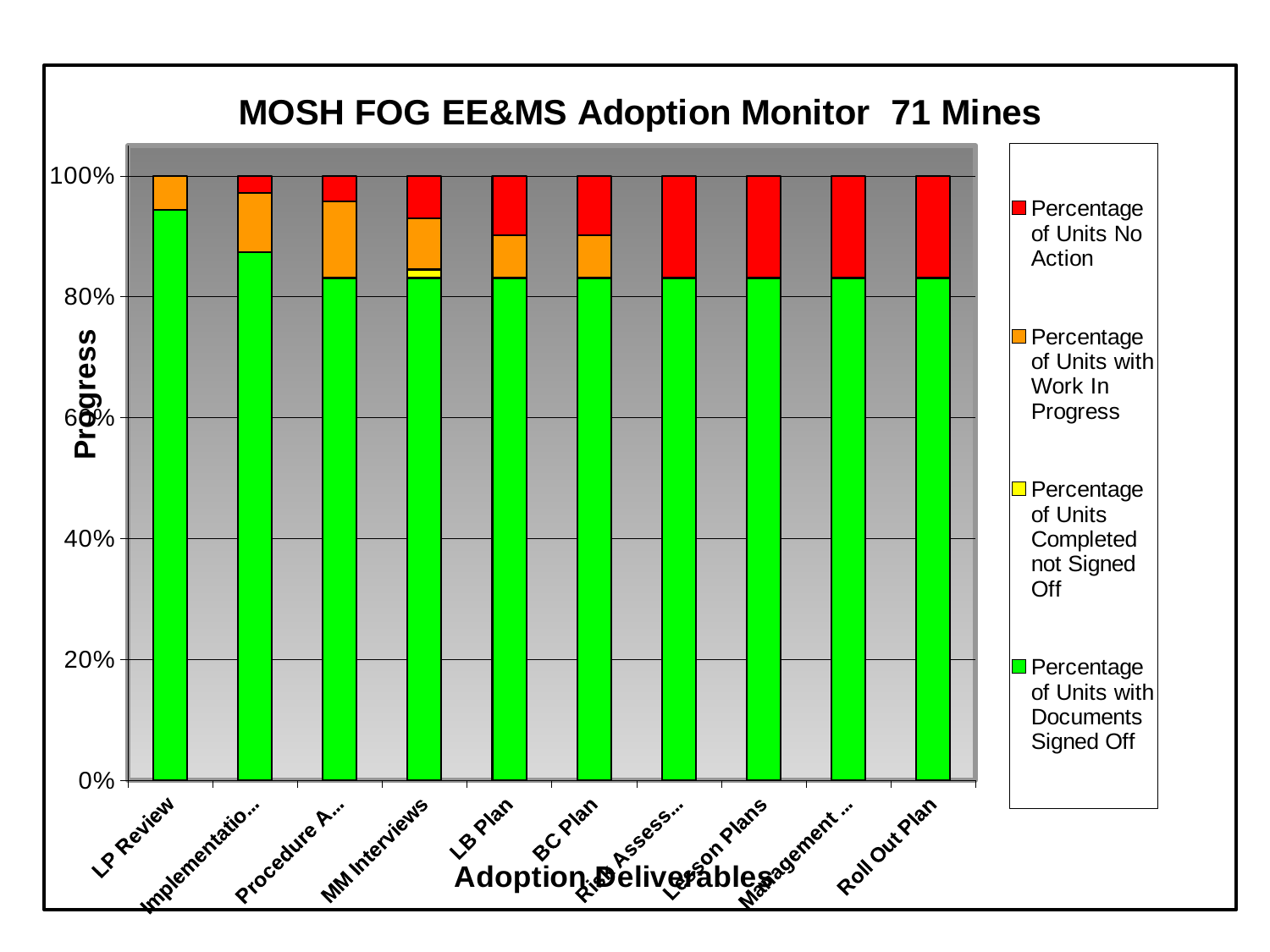
Is the Percentage of Units with Documents Signed Off for LB Plan greater or less than 100%? less Which is larger, the Percentage of Units No Action for Roll Out Plan or for LP Review? Roll Out Plan Is the Percentage of Units with Documents Signed Off for LP Review greater or less than 80%? greater How many categories are shown on the x axis? 10 What is the title of the chart? MOSH FOG EE&MS Adoption Monitor 71 Mines Which is larger, the Percentage of Units with Documents Signed Off for LP Review or for Roll Out Plan? LP Review Which category has the highest Percentage of Units with Documents Signed Off? LP Review What is the total of the stacked bar for Roll Out Plan? 100% How many series does the legend list? 4 Which category is the only one with a visible Percentage of Units Completed not Signed Off (yellow) segment? MM Interviews What is the label of the x axis? Adoption Deliverables What kind of chart is shown on the slide? Stacked bar chart